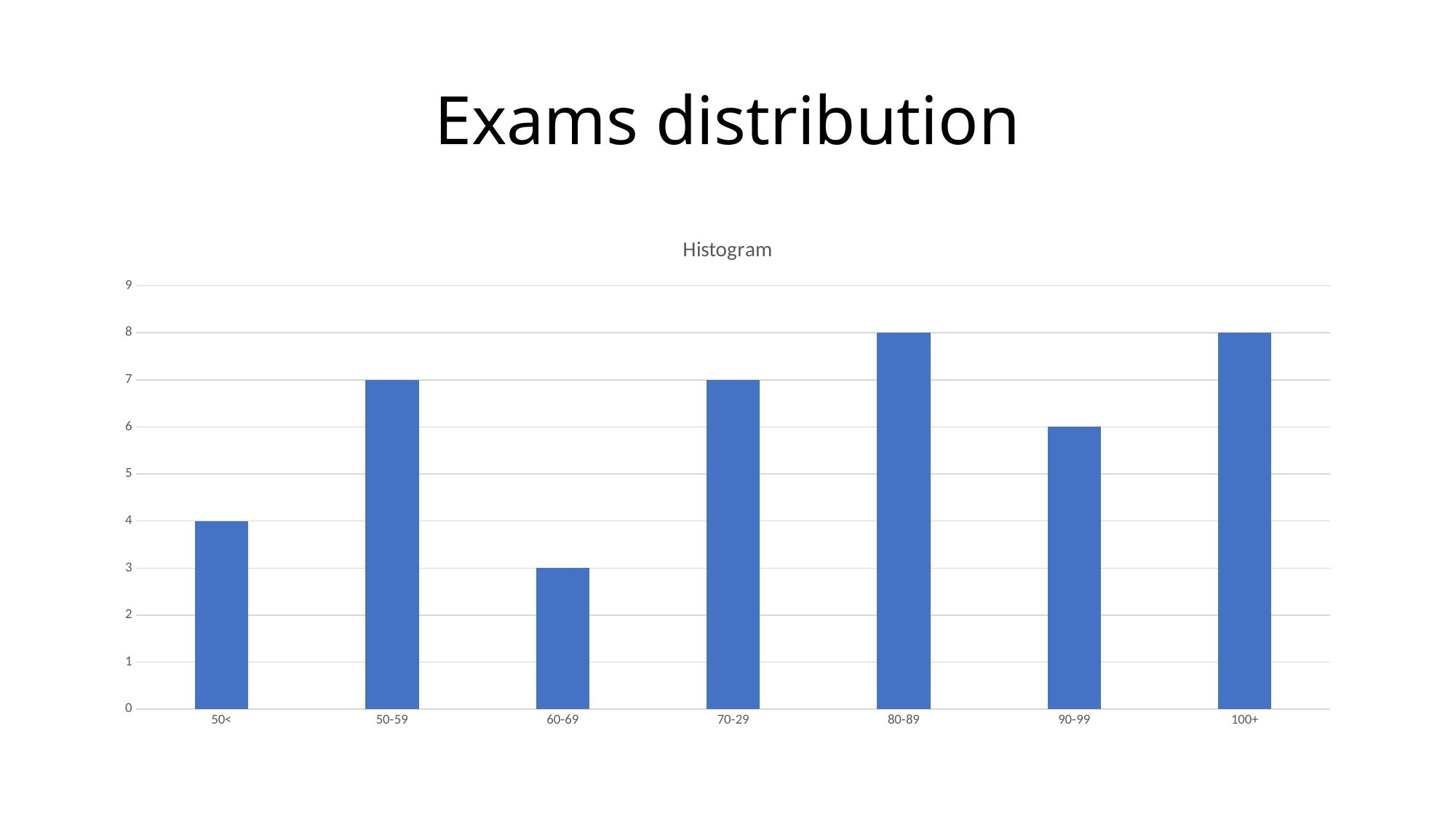
What is the value for the 90-99 category? 6 What kind of chart is shown on the slide? bar chart What is the value for the 80-89 category? 8 Which category has the lowest value? 60-69 What is the value for the 60-69 category? 3 What is the difference between the values for 50-59 and 50<? 3 What is the title of the chart? Histogram Which is larger, the value for 90-99 or the value for 60-69? 90-99 What is the value for the 50< category? 4 What is the difference between the values for 80-89 and 60-69? 5 Is the value for 50-59 greater or less than 5? greater How many categories are shown on the x axis? 7